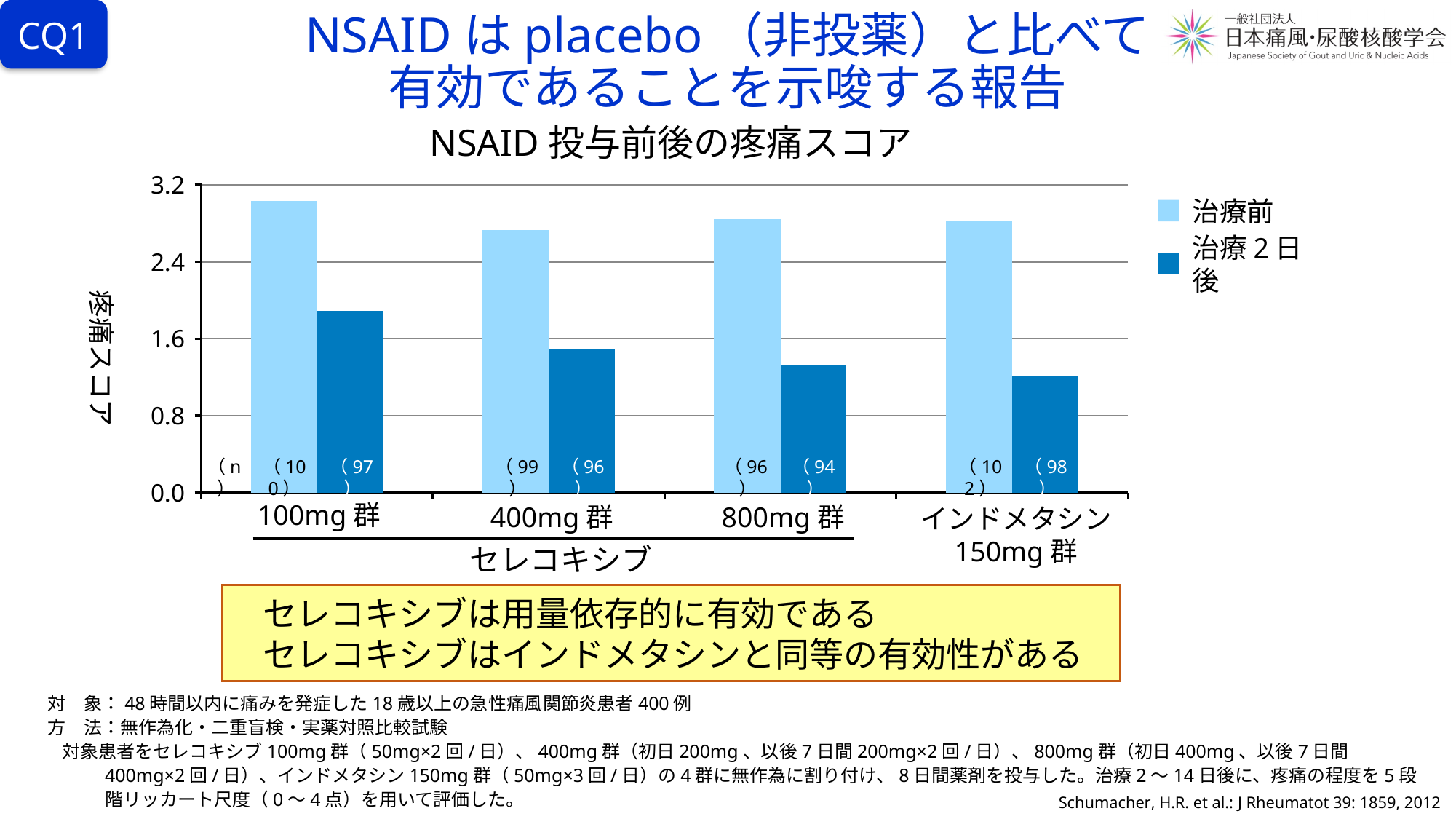
How many treatment groups (categories) are shown on the x axis? 4 What is the n printed for the 治療2日後 bar of the 100mg 群? 97 Which group has the lowest 治療前 pain score? 400mg 群 Which is larger for the 400mg 群: the 治療前 value or the 治療2日後 value? 治療前 What are the two legend entries of the chart? 治療前, 治療2日後 Which group has the highest 治療前 pain score? 100mg 群 How many series does the legend list? 2 Is the 治療2日後 value for the 800mg 群 greater or less than 1.6? less What is the title of the chart? NSAID 投与前後の疼痛スコア Which group has the lowest 治療2日後 pain score? インドメタシン 150mg 群 What kind of chart is shown on the slide? bar chart Is the 治療2日後 value for the 100mg 群 greater or less than 1.6? greater